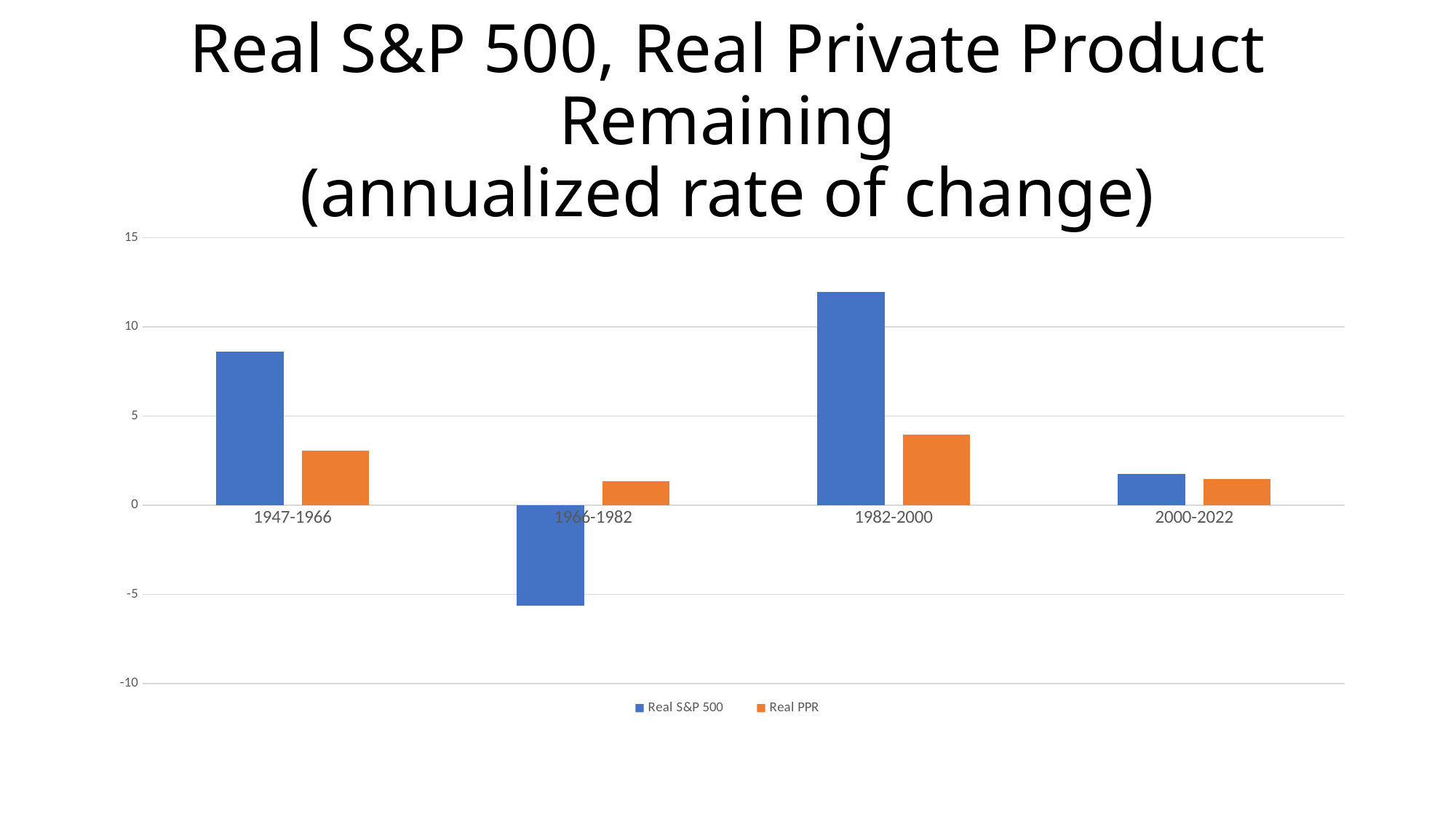
Which period has the highest Real S&P 500 value? 1982-2000 How many time periods are shown on the x axis? 4 Is the Real S&P 500 value for 1982-2000 greater or less than 10? greater Which period has the lowest Real S&P 500 value? 1966-1982 For 1947-1966, which is larger: Real S&P 500 or Real PPR? Real S&P 500 For 1966-1982, which is larger: Real S&P 500 or Real PPR? Real PPR What are the two series named in the legend? Real S&P 500 and Real PPR Which period has the highest Real PPR value? 1982-2000 What kind of chart is shown on the slide? bar chart Is the Real S&P 500 value for 1966-1982 greater or less than 0? less Is the Real PPR value for 1982-2000 greater or less than 5? less How many series does the legend list? 2